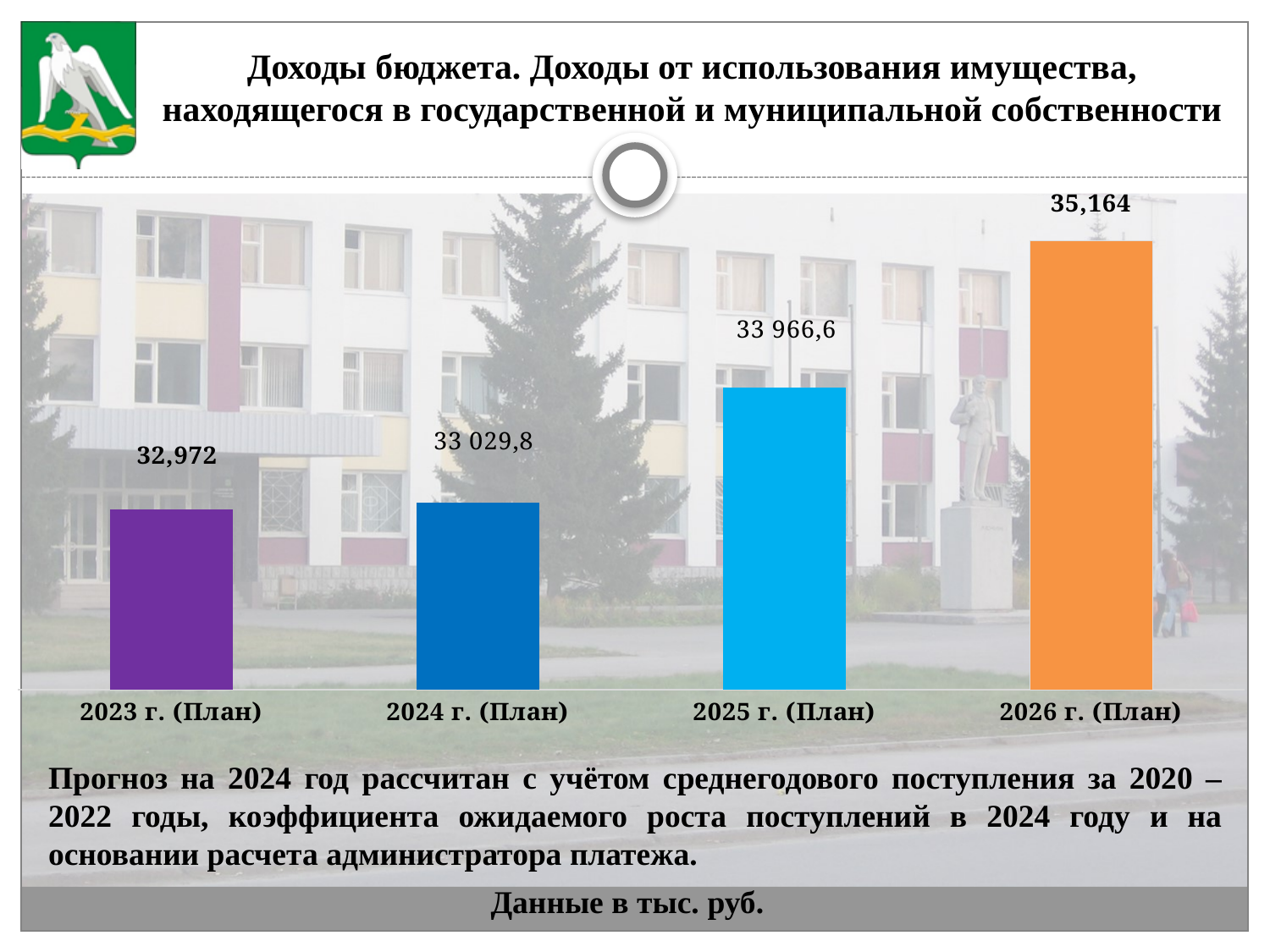
What is the value for 2026 г. (План)? 35,164 What is the value for 2024 г. (План)? 33 029,8 Which year has the highest value? 2026 г. (План) Which is larger, the value for 2025 г. (План) or the value for 2024 г. (План)? 2025 г. (План) What is the value for 2023 г. (План)? 32,972 Which year has the lowest value? 2023 г. (План) What kind of chart is shown on the slide? Bar chart What is the value for 2025 г. (План)? 33 966,6 In what units are the chart data given, according to the slide? тыс. руб. What is the difference between the values for 2025 г. (План) and 2024 г. (План)? 936,8 Do the values rise or fall from 2023 to 2026? Rise How many bars are shown in the chart? 4